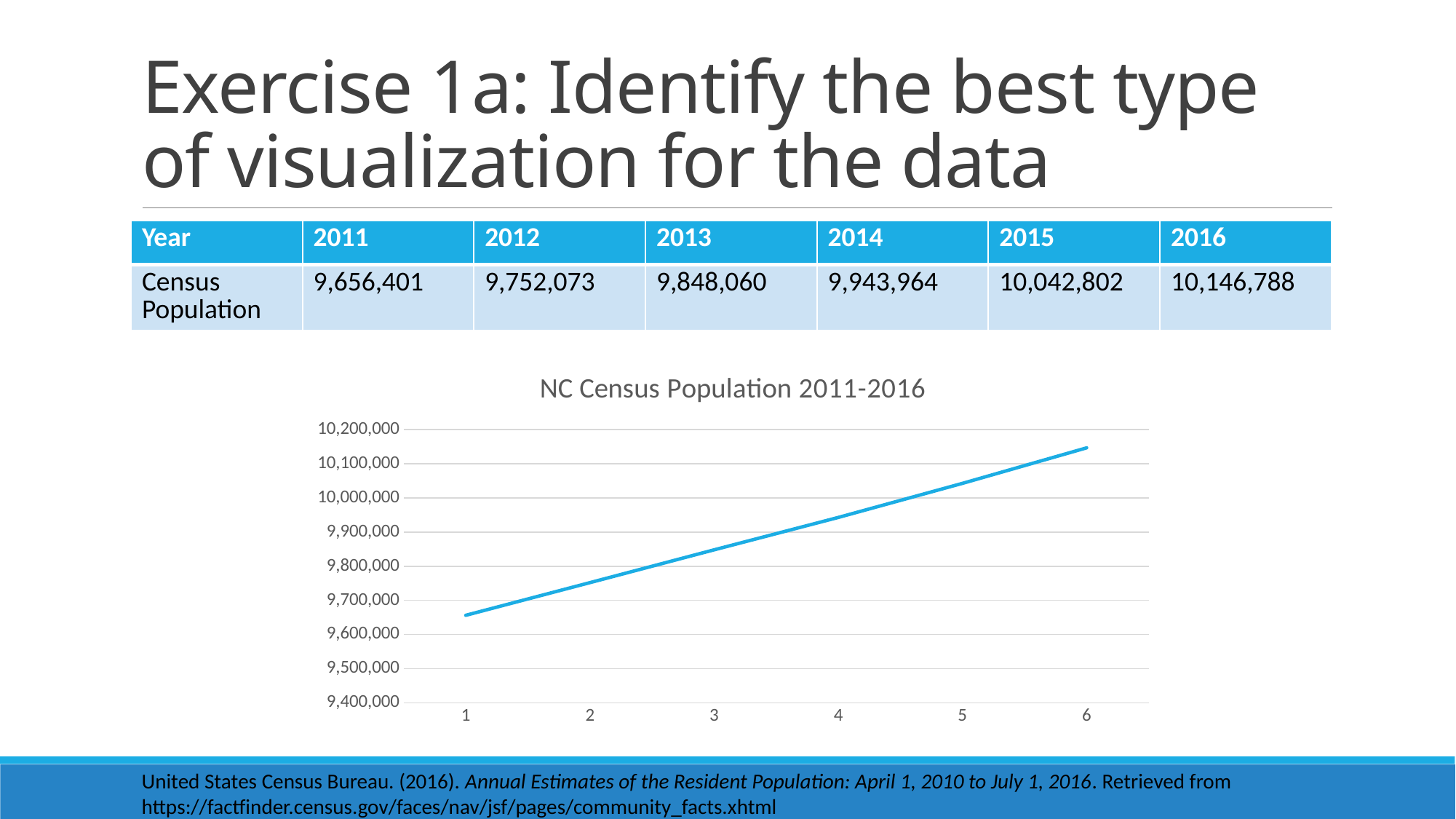
How many points are plotted along the x axis of the chart? 6 What type of chart is shown on the slide? line chart What is the title of the chart? NC Census Population 2011-2016 According to the table on the slide, which year has the highest census population? 2016 According to the table on the slide, what is the difference between the 2016 and 2011 census populations? 490,387 In the chart, is the value at x = 4 greater or less than 10,000,000? less In the chart, is the value at x = 6 greater or less than 10,100,000? greater What is the lowest value labelled on the chart's vertical axis? 9,400,000 According to the table on the slide, what was the census population in 2013? 9,848,060 In the chart, is the value at x = 1 greater or less than 9,700,000? less Do the values in the chart rise or fall from left to right along the x axis? rise